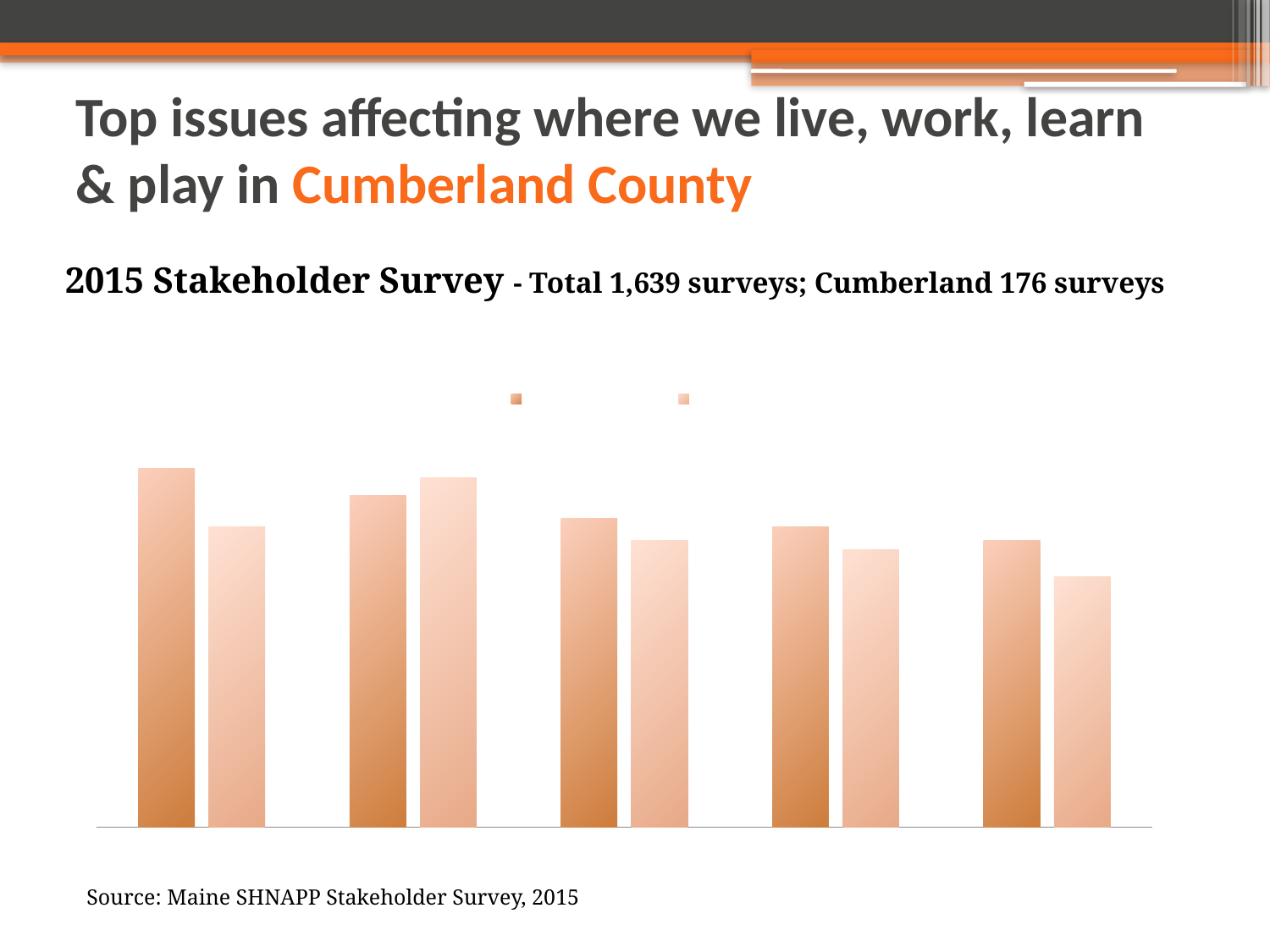
Which group of bars, counting from the left, has the tallest dark orange bar? the first group Do the dark orange bars rise or fall from left to right across the chart? fall How many series does the chart's legend list? 2 What two colours are used for the bars in the chart? dark orange and light orange Which group of bars, counting from the left, has the shortest light orange bar? the fifth group Which group of bars, counting from the left, has the shortest dark orange bar? the fifth group Do the light orange bars rise or fall from the second group to the fifth group? fall How many groups of bars (categories) are plotted in the chart? 5 In how many of the five groups is the dark orange bar taller than the light orange bar? 4 In the first group from the left, which bar is taller, the dark orange bar or the light orange bar? the dark orange bar In the second group from the left, which bar is taller, the dark orange bar or the light orange bar? the light orange bar What kind of chart is shown on the slide? bar chart